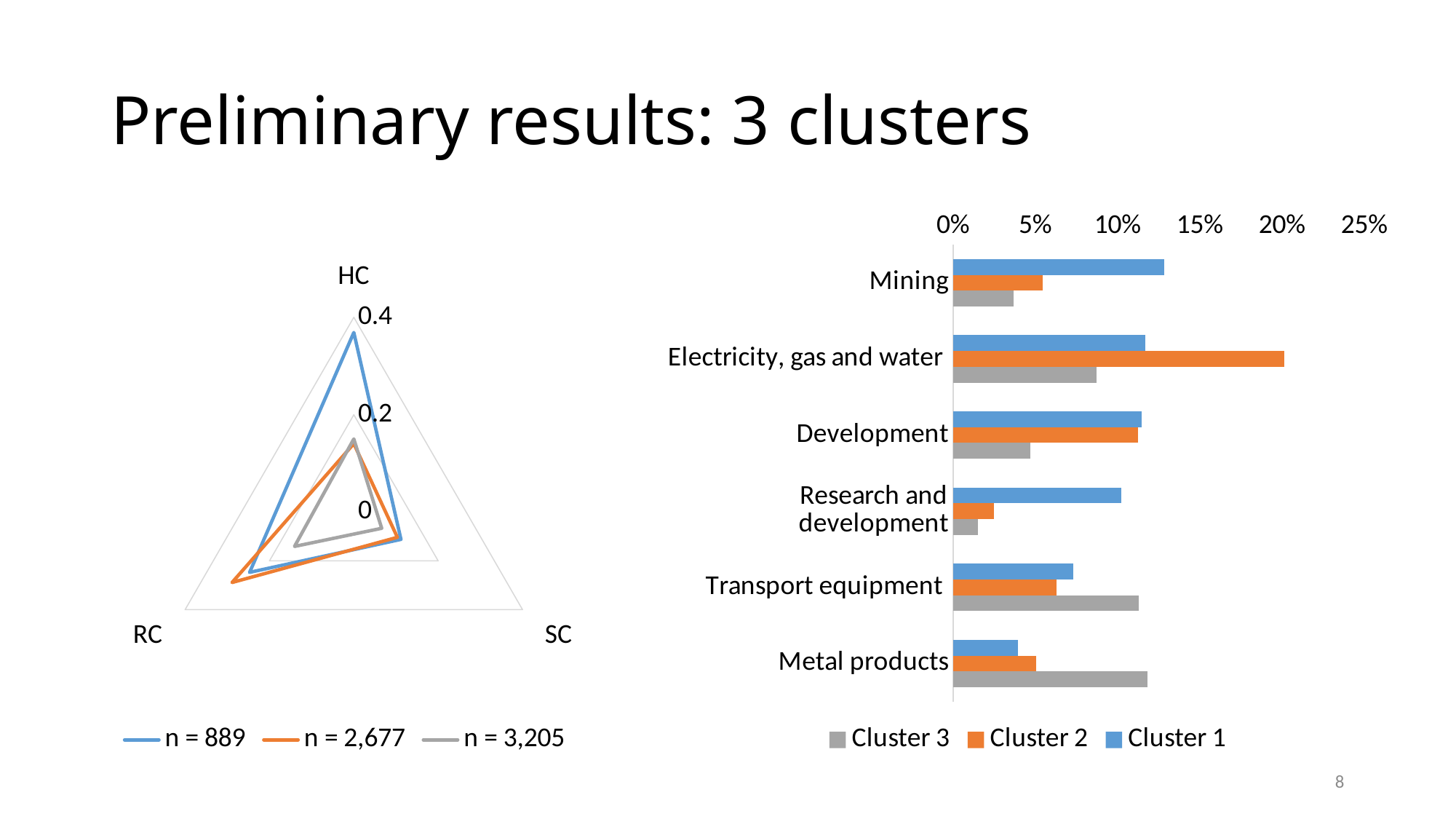
In the radar chart on the left, is the HC value for the n = 889 series greater or less than 0.2? greater What kind of chart is the chart on the left of the slide? radar chart In the bar chart on the right, which category has the shortest Cluster 3 bar? Research and development In the bar chart on the right, for Metal products, which is larger: the Cluster 1 bar or the Cluster 3 bar? Cluster 3 In the bar chart on the right, which category has the longest Cluster 2 bar? Electricity, gas and water In the bar chart on the right, is the Cluster 3 value for Mining greater or less than 5%? less In the radar chart on the left, how many series does the legend list? 3 In the bar chart on the right, is the Cluster 2 value for Electricity, gas and water greater or less than 15%? greater In the bar chart on the right, how many series does the legend list? 3 In the bar chart on the right, which category has the longest Cluster 1 bar? Mining What kind of chart is the chart on the right of the slide? bar chart In the bar chart on the right, how many industry categories are shown? 6